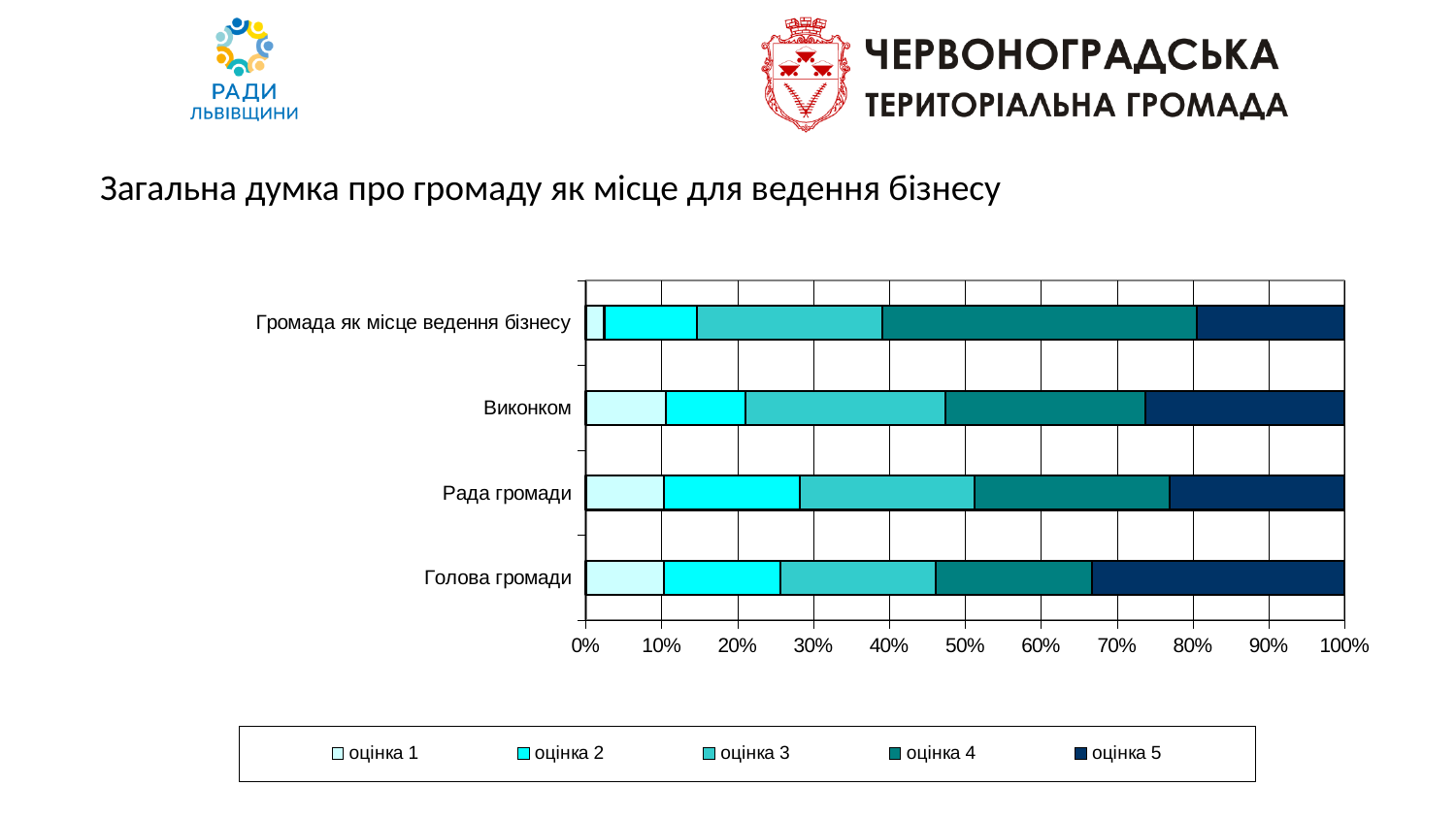
Which is larger: the оцінка 5 segment for Голова громади or for Громада як місце ведення бізнесу? Голова громади Which category has the largest оцінка 5 segment? Голова громади What kind of chart is shown on the slide? Stacked bar chart What is the title of the slide above the chart? Загальна думка про громаду як місце для ведення бізнесу Is the value of оцінка 5 for Громада як місце ведення бізнесу greater or less than 30%? less How many series does the chart legend list? 5 What is the last entry in the chart legend? оцінка 5 Is the value of оцінка 5 for Голова громади greater or less than 20%? greater Is the value of оцінка 1 for Громада як місце ведення бізнесу greater or less than 10%? less How many categories are plotted on the vertical axis of the chart? 4 Which category has the smallest оцінка 1 segment? Громада як місце ведення бізнесу Which category has the largest оцінка 4 segment? Громада як місце ведення бізнесу